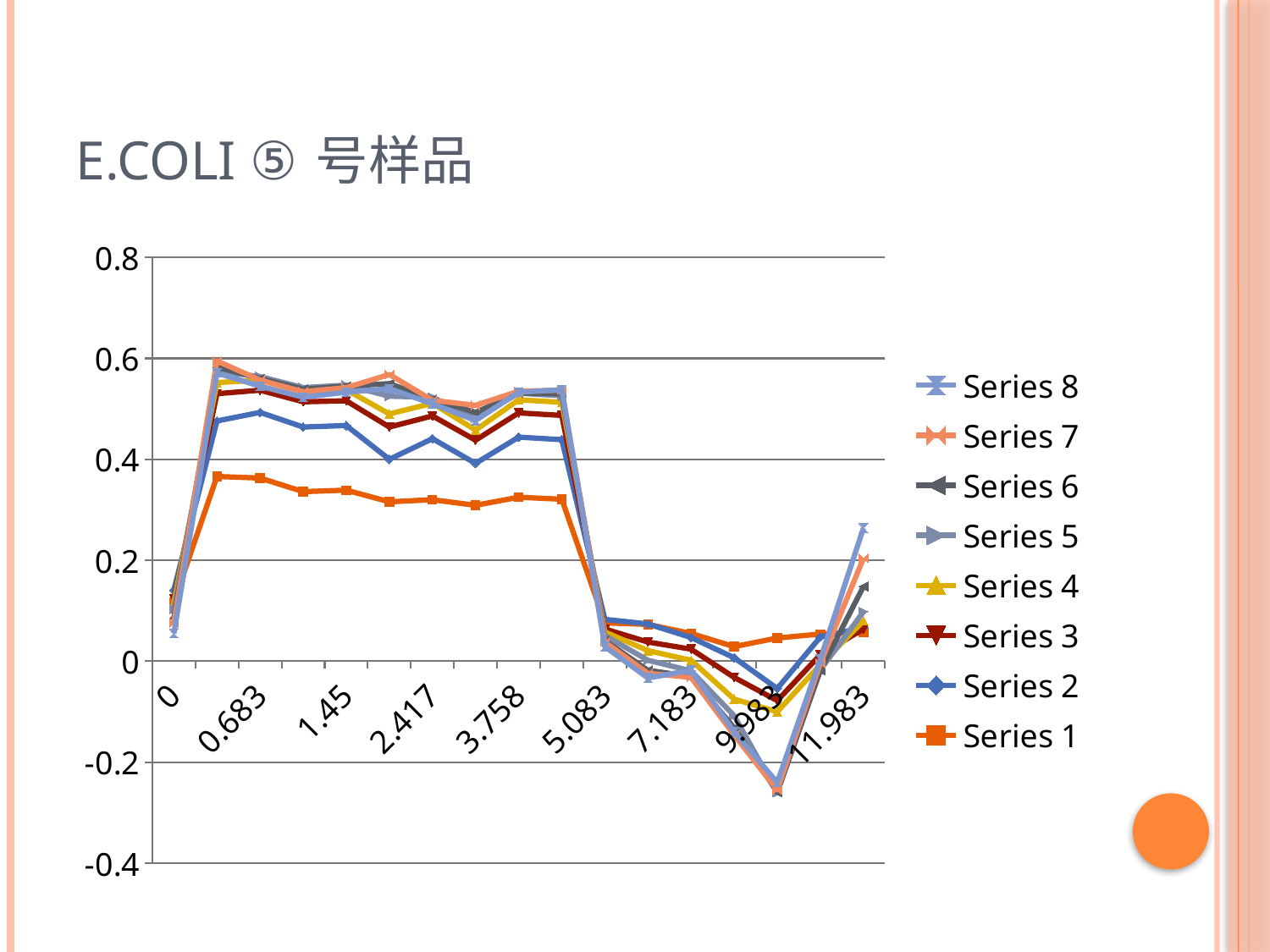
Is the value for Series 1 at x = 9.983 greater or less than 0? greater Which series has the lowest value at x = 0.683? Series 1 What kind of chart is shown on the slide? line chart At x = 9.983, which is larger: Series 1 or Series 8? Series 1 Is the value for Series 8 at x = 9.983 greater or less than -0.2? less Is the value for Series 2 at x = 0.683 greater or less than 0.4? greater Which series has the highest value at x = 11.983? Series 8 How many labels are shown along the x axis? 9 How many series does the legend list? 8 At x = 0.683, which is larger: Series 1 or Series 7? Series 7